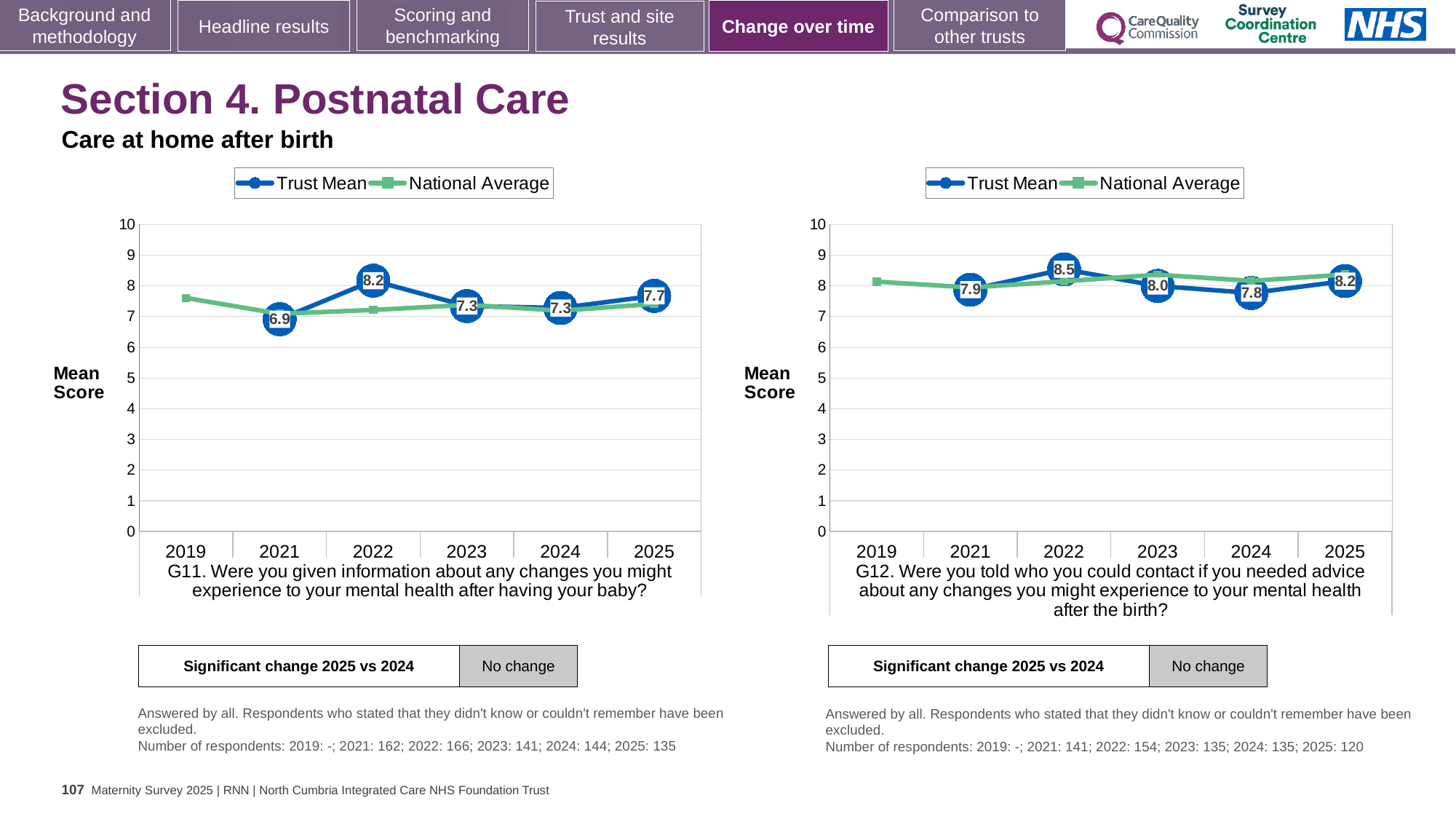
In the G11 chart (left), is the National Average value for 2019 greater or less than 7? greater How many series does the legend of the G11 chart (left) list? 2 In the G12 chart (right), is the Trust Mean score higher in 2025 or in 2021? 2025 In the G12 chart (right), what is the difference between the Trust Mean scores for 2022 and 2024? 0.7 What type of chart is the G12 chart (right)? Line chart How many years are shown on the x axis of the G12 chart (right)? 6 In the G12 chart (right), what is the Trust Mean score for 2024? 7.8 In the G11 chart (left), what is the Trust Mean score for 2025? 7.7 In the G11 chart (left), which year has the lowest Trust Mean score? 2021 In the G11 chart (left), what is the Trust Mean score for 2022? 8.2 In the G11 chart (left), what is the difference between the Trust Mean scores for 2022 and 2021? 1.3 In the G12 chart (right), which year has the highest Trust Mean score? 2022